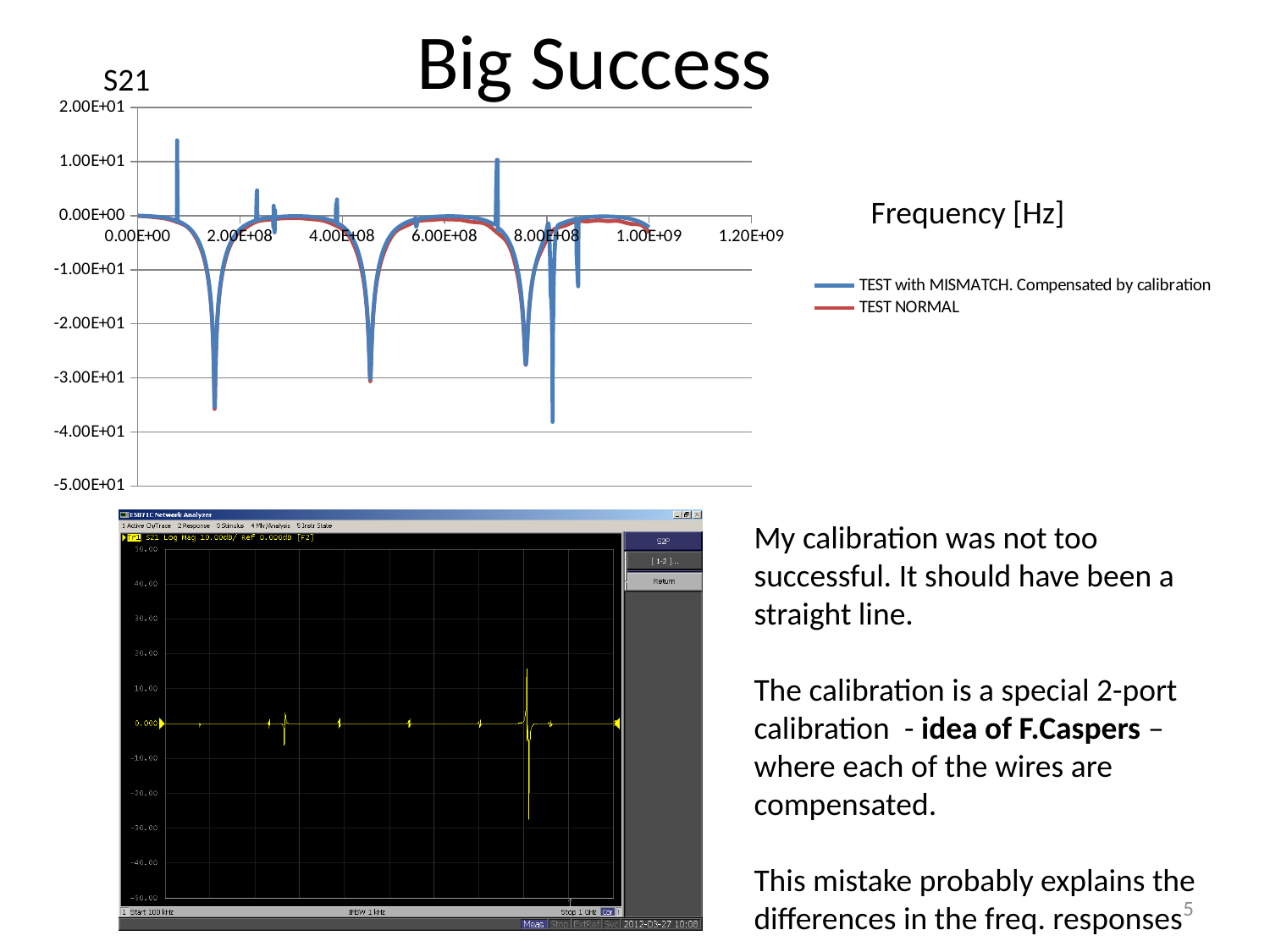
In the top chart, what is the highest value shown on the y axis? 2.00E+01 In the top chart, is the spike of the TEST with MISMATCH series near 1.0E+08 Hz greater or less than 1.00E+01? greater In the top chart, what is the highest value shown on the x axis? 1.20E+09 How many tick labels are shown on the x axis of the top chart? 7 In the top chart, what is the lowest value shown on the y axis? -5.00E+01 In the network analyzer screenshot at the bottom left, what is the highest value shown on the vertical scale? 50.00 What kind of chart is the top chart on the slide? line chart In the top chart, what is the label on the vertical axis? S21 In the top chart, is the dip of the TEST with MISMATCH series near 7.5E+08 Hz greater or less than -2.00E+01? less What are the two legend entries of the top chart? TEST with MISMATCH. Compensated by calibration; TEST NORMAL In the top chart, is the deepest dip of the TEST with MISMATCH series (near 8.5E+08 Hz) greater or less than -3.00E+01? less How many series does the legend of the top chart list? 2